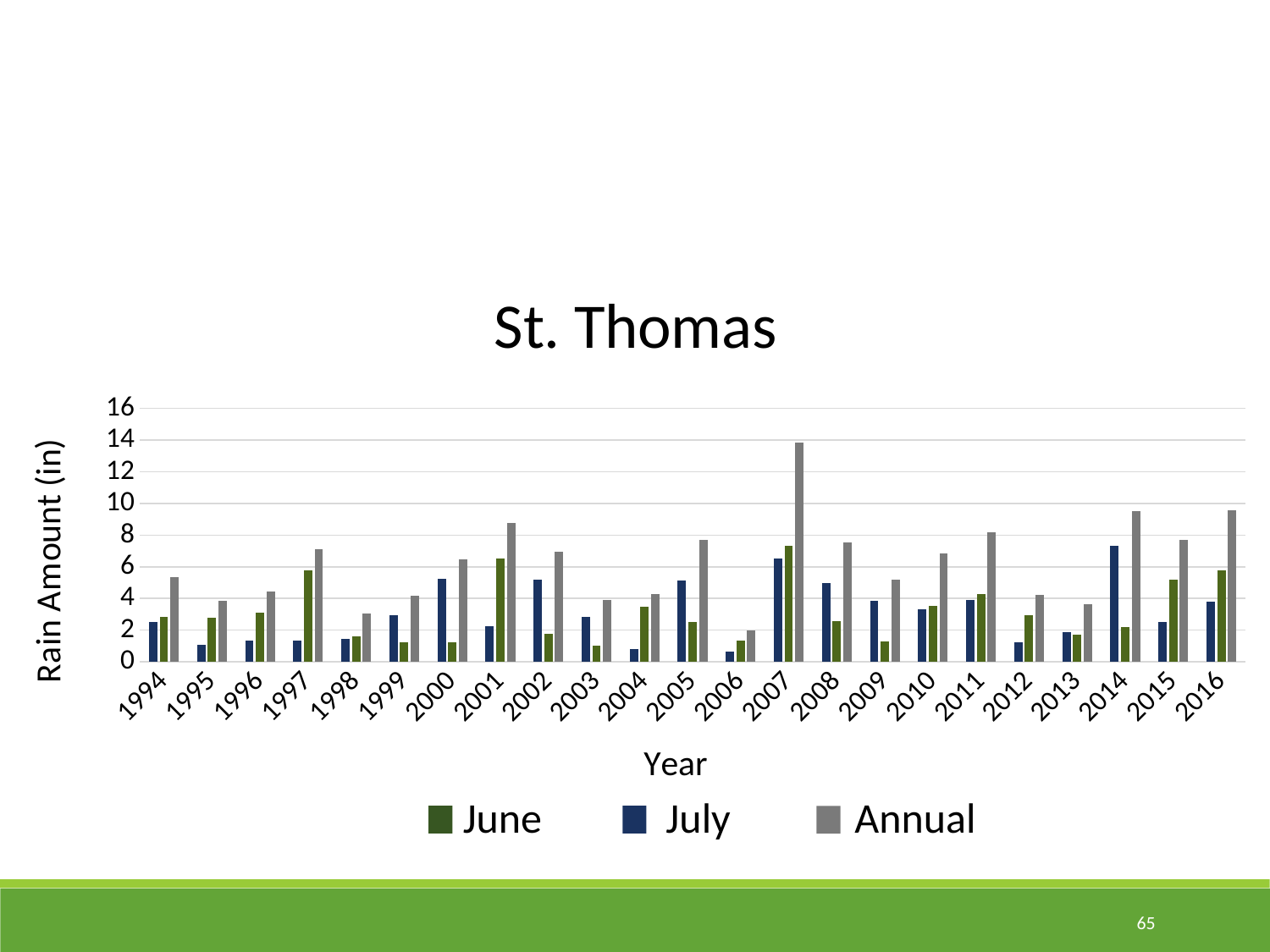
Which year has the highest June rain amount? 2007 What kind of chart is shown on the slide? bar chart In 2000, which is larger, the June value or the July value? July Which year has the highest July rain amount? 2014 What is the label on the y axis? Rain Amount (in) Is the July value for 2014 greater or less than 6? greater Is the Annual value for 2007 greater or less than 12? greater Is the Annual value for 2006 greater or less than 4? less How many years are shown along the x axis? 23 Which year has the lowest Annual rain amount? 2006 Which year has the highest Annual rain amount? 2007 How many series does the legend list? 3